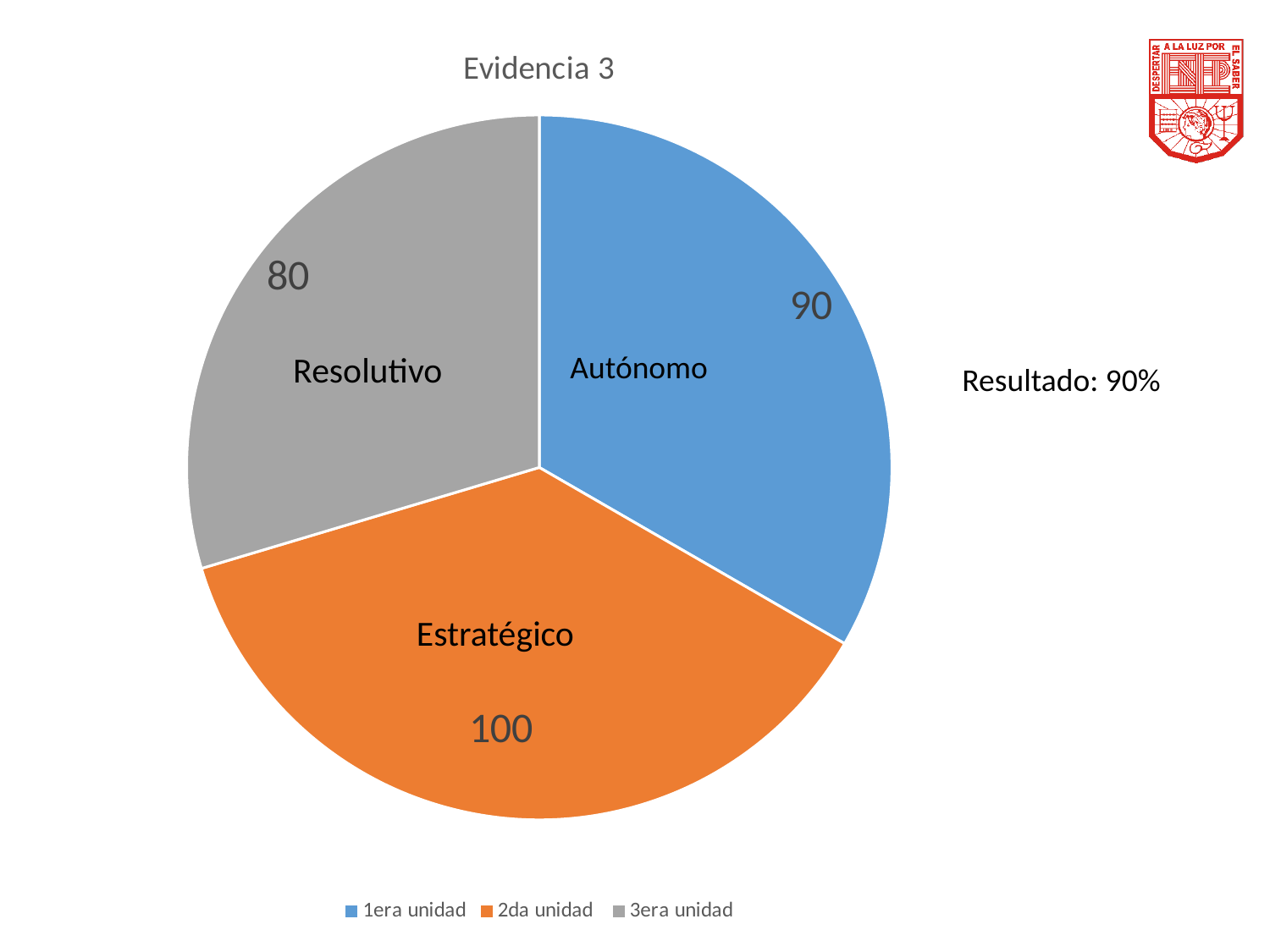
How many slices does the pie chart have? 3 What is the title of the chart? Evidencia 3 What is the total of all three slice values? 270 How many entries does the legend list? 3 What value is shown for the Resolutivo slice? 80 What value is shown for the Autónomo slice? 90 What value is shown for the Estratégico slice? 100 What type of chart is shown on the slide? Pie chart What is the difference between the Estratégico and Resolutivo values? 20 Which slice has the highest value? Estratégico Which slice has the lowest value? Resolutivo Which is larger, the Autónomo value or the Resolutivo value? Autónomo